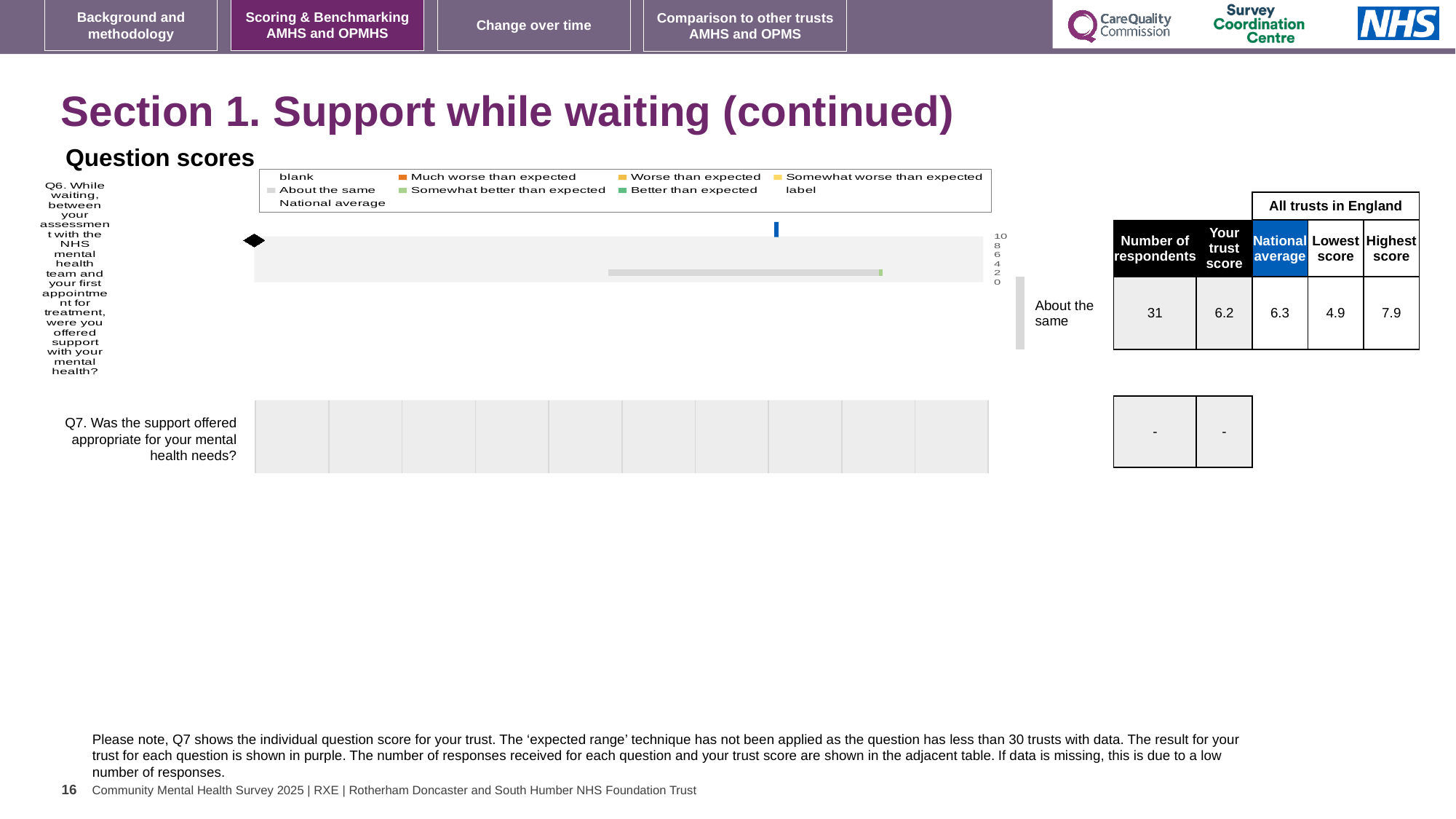
What is the lowest score among all trusts in England for Q6? 4.9 What is the difference between the highest and lowest scores for Q6 across all trusts in England? 3.0 How many respondents answered Q6? 31 Which expected-range category is Q6 placed in for this trust? About the same What is the highest score among all trusts in England for Q6? 7.9 What kind of chart is used to show the question scores? Bar chart Which legend entry is shown in orange? Much worse than expected What is the national average score for Q6? 6.3 Which is larger for Q6: the trust score or the national average? National average What is shown as the trust score for Q7 (was the support offered appropriate for your mental health needs)? - By how much does the national average exceed the trust score for Q6? 0.1 What is the trust score for Q6 (support offered with your mental health while waiting)? 6.2